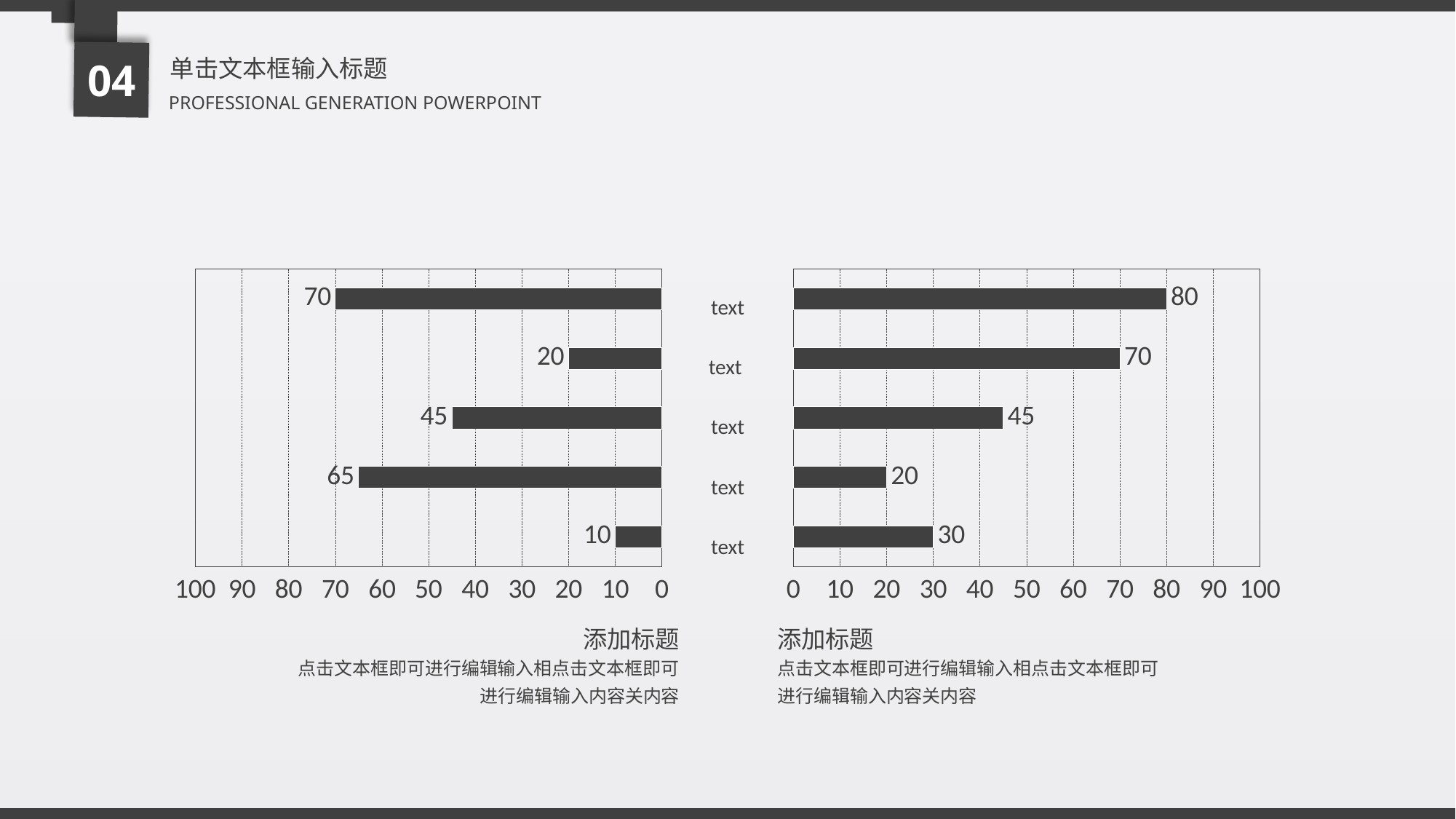
In the left chart, what is the difference between the top bar (70) and the bottom bar (10)? 60 In the right chart, what is the value of the bottom bar? 30 What kind of chart is the left chart on the slide? bar chart Which is larger: the second bar from the top in the left chart or the second bar from the top in the right chart? the right chart's second bar (70) In the left chart, what is the value of the fourth bar from the top? 65 In which direction does the horizontal axis of the left chart run, from 0 to 100 or from 100 to 0 (left to right)? from 100 to 0 How many bars does the right chart on the slide have? 5 In the right chart, what is the highest value shown? 80 In the right chart, is the value of the third bar from the top greater or less than 50? less In the right chart, what is the difference between the top bar (80) and the fourth bar (20)? 60 In the left chart, what is the value of the top bar? 70 In the left chart, what is the lowest value shown? 10